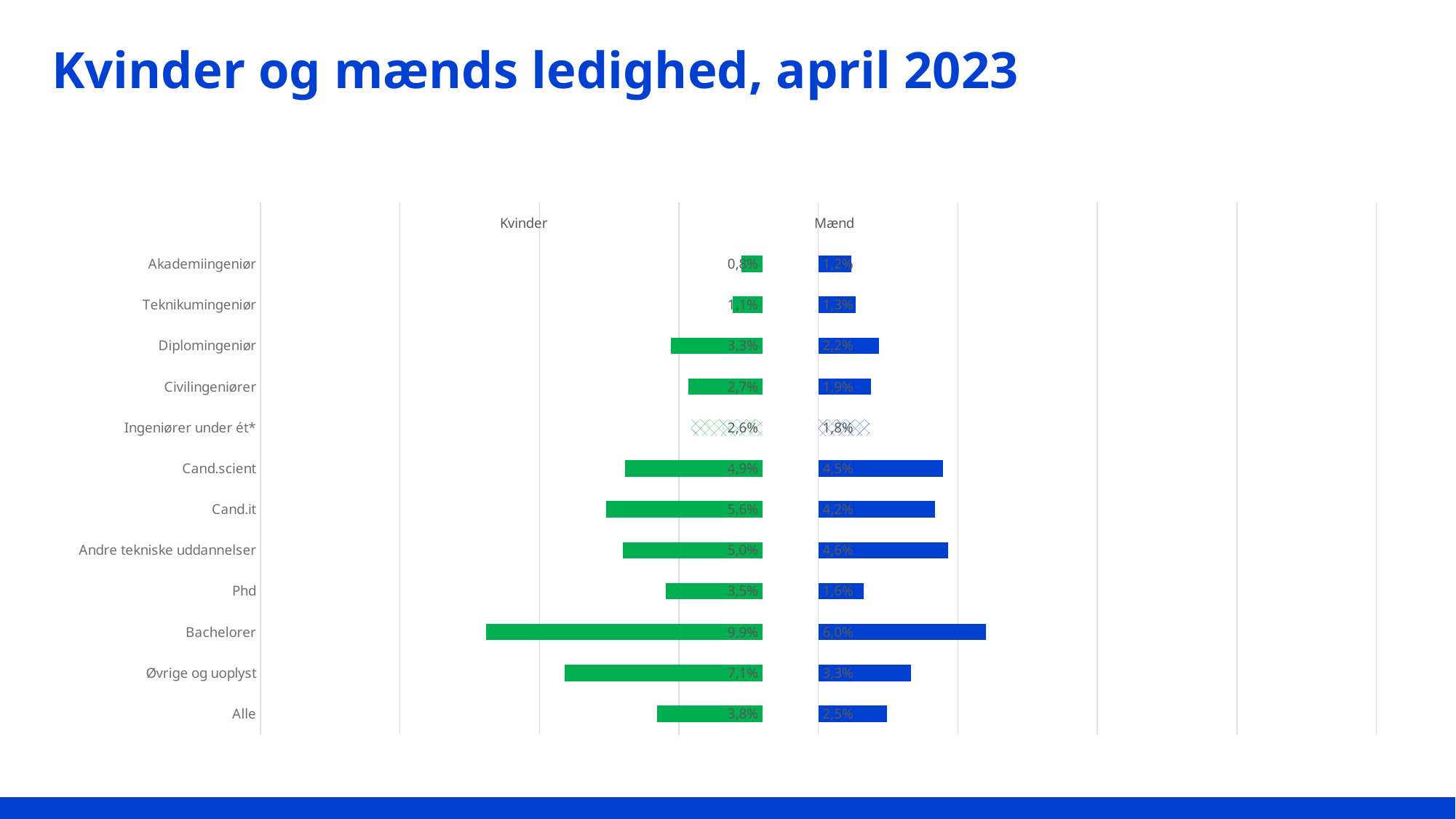
What is the difference between the Kvinder and Mænd values for Øvrige og uoplyst? 3,8 percentage points What is the value for Kvinder in the Alle category? 3,8% Which category has the lowest unemployment rate for Kvinder? Akademiingeniør What is the unemployment rate for Kvinder (women) in the Bachelorer category? 9,9% What type of chart is shown on the slide? Bar chart What is the unemployment rate for Mænd (men) in the Cand.scient category? 4,5% How many categories are shown on the chart? 12 Which category has the highest unemployment rate for Kvinder? Bachelorer For Diplomingeniør, which is larger: the Kvinder value or the Mænd value? Kvinder How many series does the chart show? 2 What is the value for Mænd in the Phd category? 1,6% Which category has the highest unemployment rate for Mænd? Bachelorer